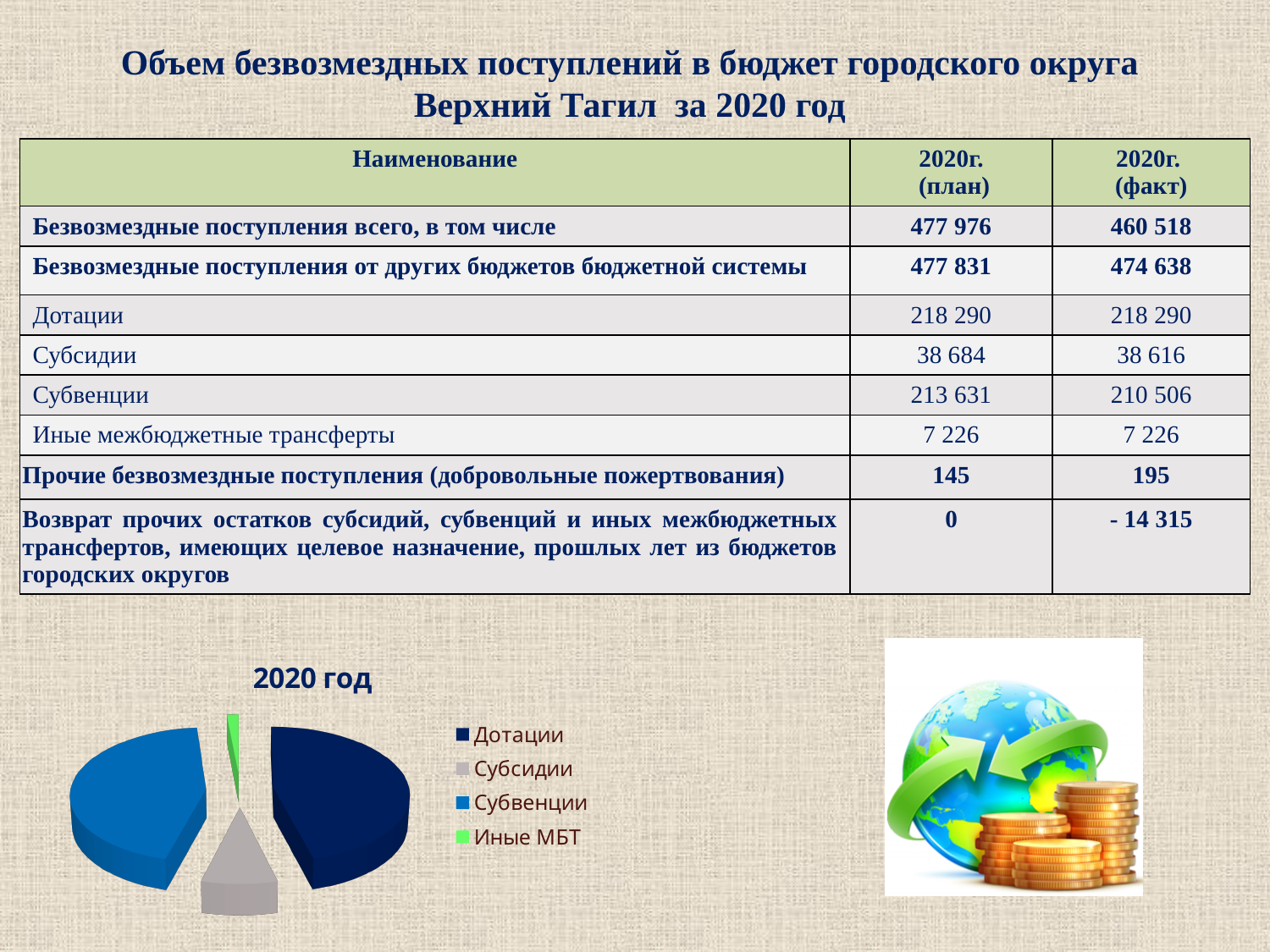
How many slices does the pie chart have? 4 What kind of chart is shown on the slide? pie chart What colour represents Иные МБТ in the pie chart? green In the pie chart, which slice is larger: Субсидии or Иные МБТ? Субсидии Which category has the smallest slice in the pie chart? Иные МБТ In the pie chart, which slice is larger: Субвенции or Иные МБТ? Субвенции What is the title of the pie chart? 2020 год How many entries does the legend of the pie chart list? 4 In the pie chart, which slice is larger: Дотации or Субсидии? Дотации